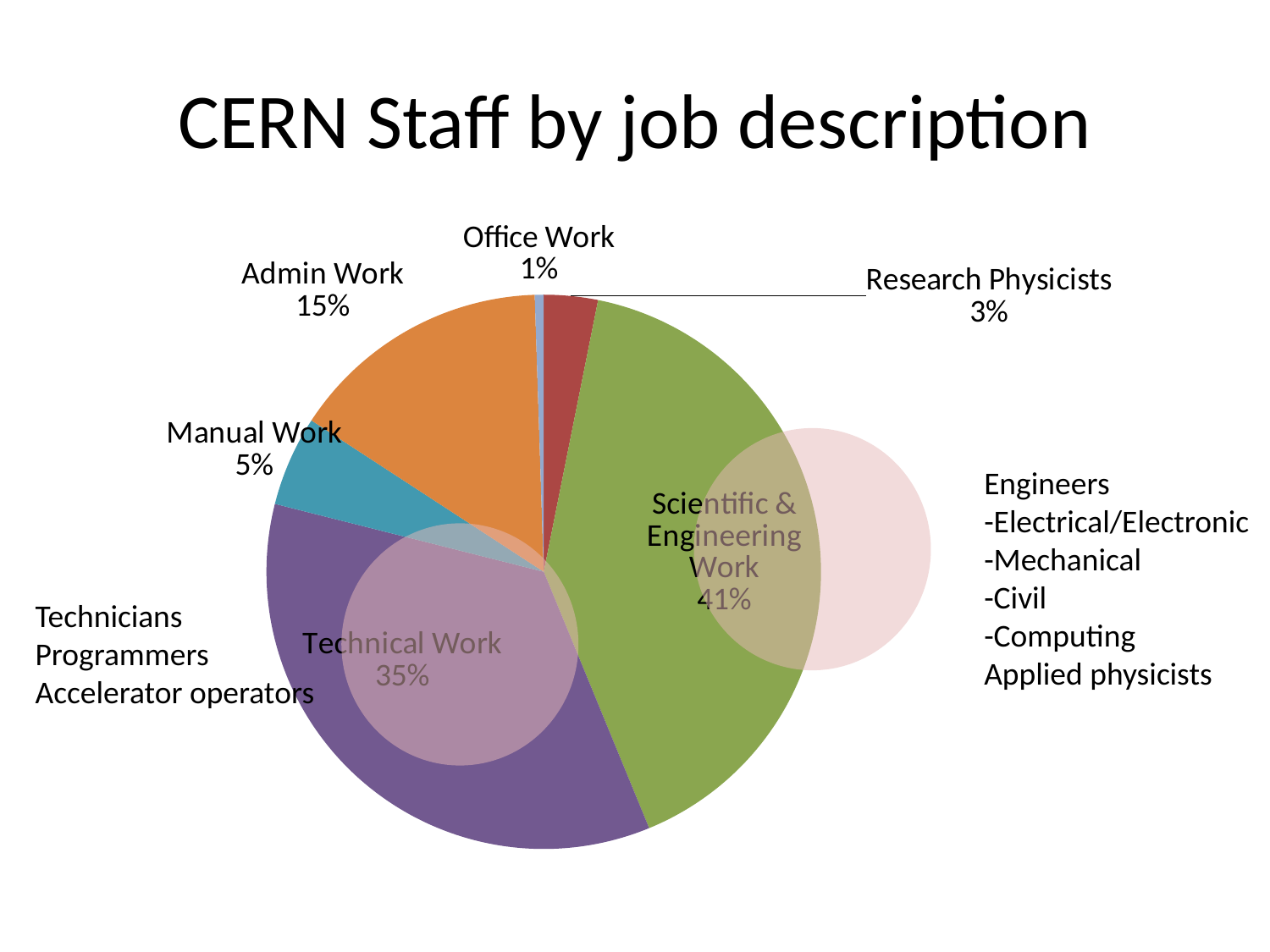
What percentage of CERN staff is in Scientific & Engineering Work? 41% What percentage of CERN staff are Research Physicists? 3% What type of chart is shown on the slide? Pie chart What is the title of the chart? CERN Staff by job description What percentage of CERN staff is in Technical Work? 35% What percentage of CERN staff is in Manual Work? 5% What is the difference in percentage points between Scientific & Engineering Work and Technical Work? 6 Which job category has the largest share of CERN staff? Scientific & Engineering Work What percentage of CERN staff is in Admin Work? 15% Which job category has the smallest share of CERN staff? Office Work Which is larger, the share for Admin Work or the share for Manual Work? Admin Work How many job categories are shown in the pie chart? 6